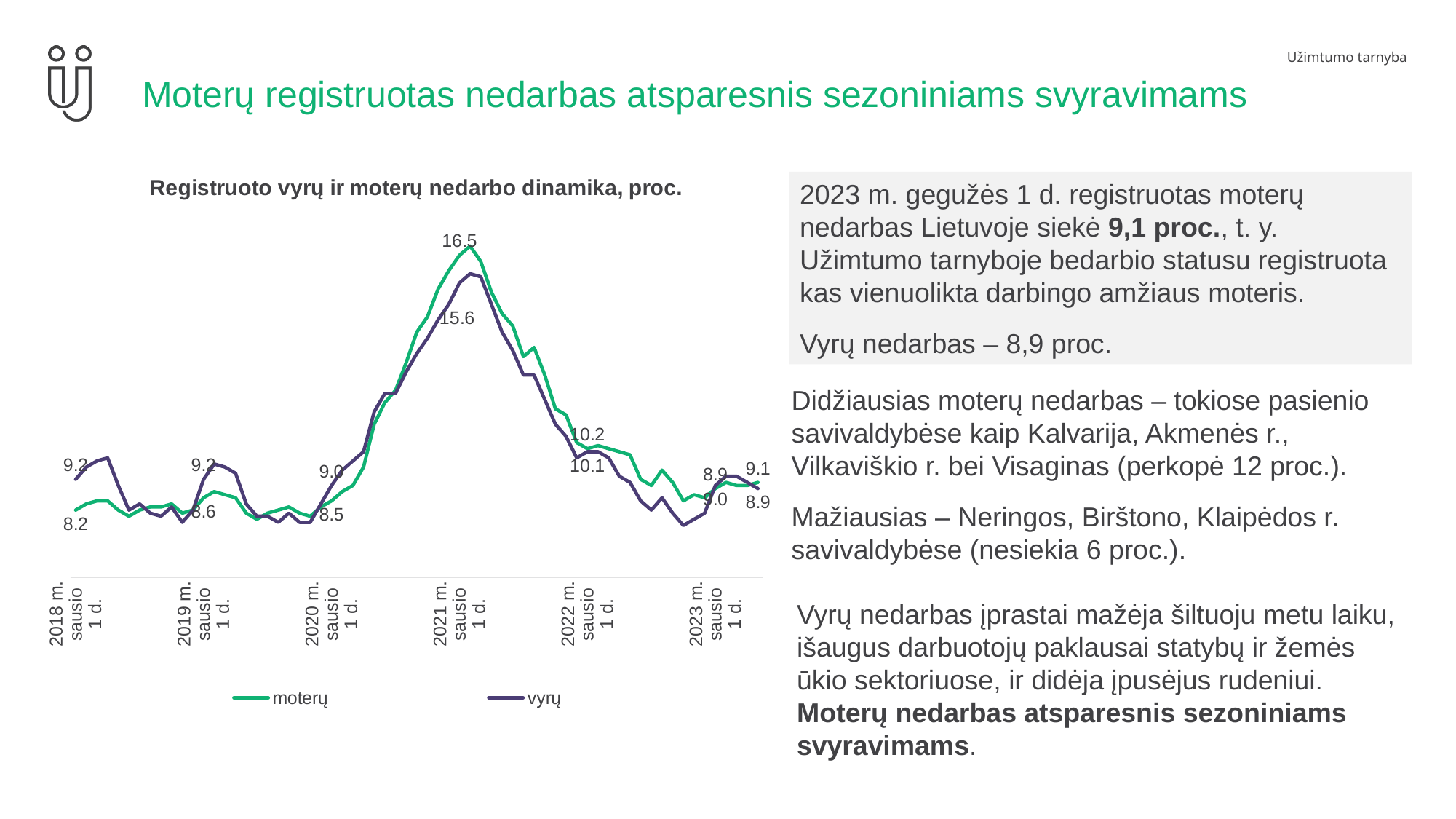
What is the difference between the moterų and vyrų values at 2021 m. sausio 1 d.? 0.9 What type of chart is shown on the slide? line chart What is the title of the chart? Registruoto vyrų ir moterų nedarbo dinamika, proc. What is the value for vyrų at 2021 m. sausio 1 d.? 15.6 At which labelled date does the moterų series reach its highest value? 2021 m. sausio 1 d. What is the last labelled value of the moterų series at the right end of the chart? 9.1 What is the value for moterų at 2018 m. sausio 1 d.? 8.2 What is the value for moterų at 2021 m. sausio 1 d.? 16.5 What is the value for vyrų at 2018 m. sausio 1 d.? 9.2 At 2018 m. sausio 1 d., which series has the higher value, moterų or vyrų? vyrų Does the moterų series rise or fall between 2021 m. sausio 1 d. and 2022 m. sausio 1 d.? fall How many series does the chart legend list? 2